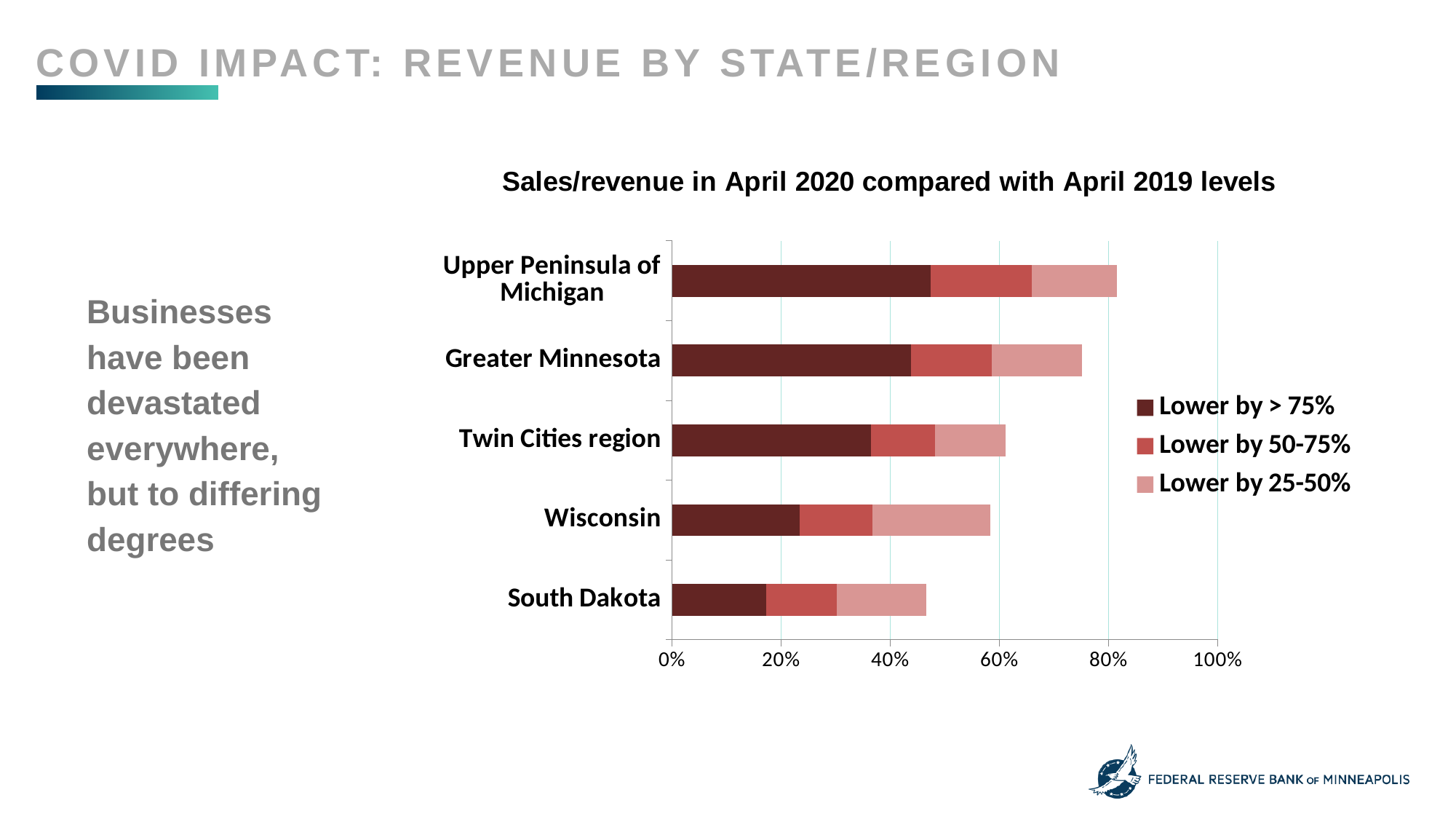
Which state/region has the shortest total bar? South Dakota What is the title of the chart? Sales/revenue in April 2020 compared with April 2019 levels Which state/region has the longest total bar? Upper Peninsula of Michigan Which state/region has the smallest 'Lower by > 75%' segment? South Dakota How many series does the chart legend list? 3 Is the total bar for South Dakota greater or less than 40%? greater Is the 'Lower by > 75%' segment for Upper Peninsula of Michigan greater or less than 40%? greater How many states/regions are plotted in the chart? 5 Which legend entry is shown in the darkest colour? Lower by > 75% Which has the longer total bar, Greater Minnesota or Wisconsin? Greater Minnesota Is the total bar for Greater Minnesota greater or less than 80%? less What kind of chart is shown on the slide? Stacked bar chart